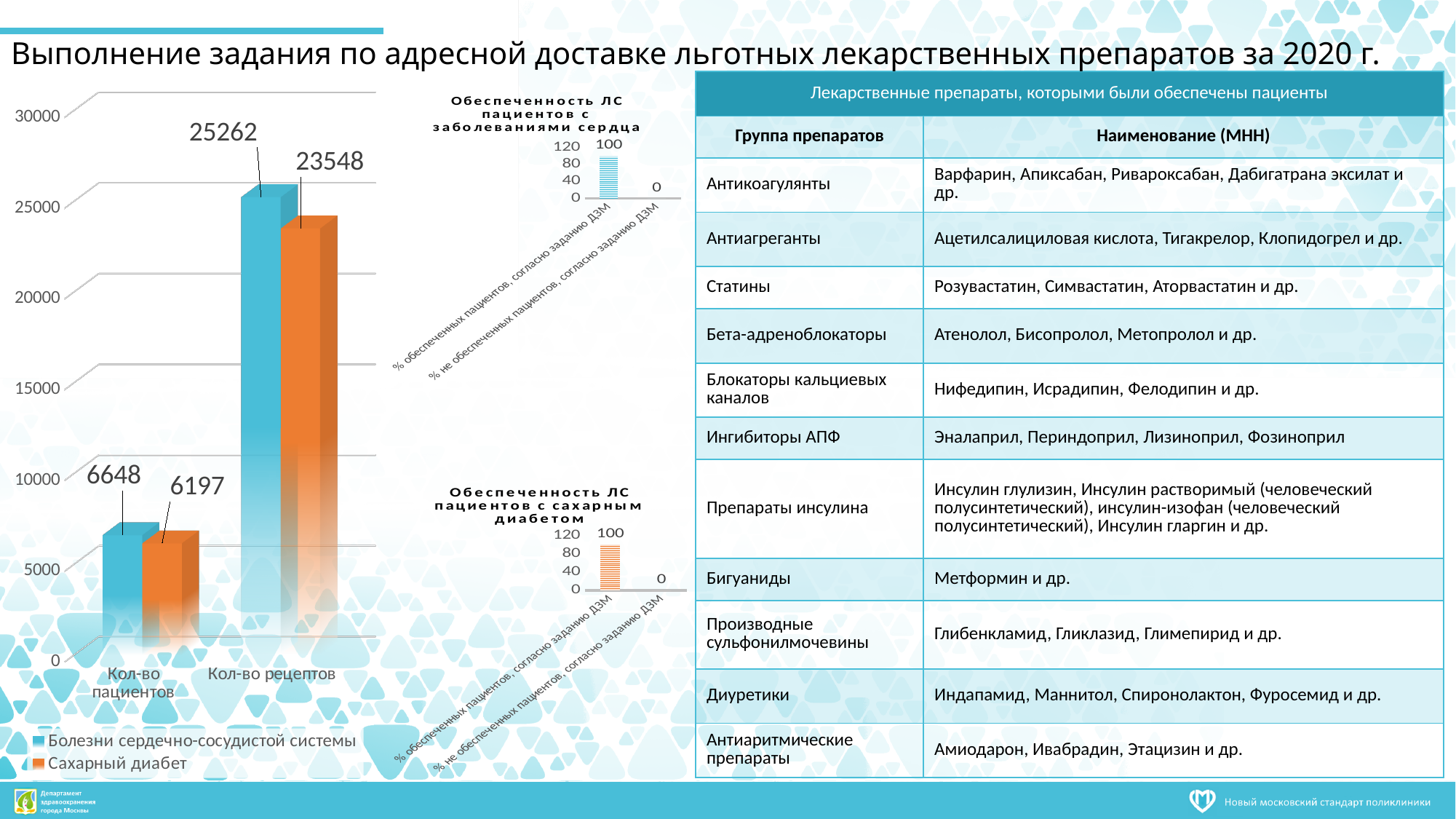
In the chart titled 'Обеспеченность ЛС пациентов с сахарным диабетом', what is the value for '% не обеспеченных пациентов, согласно заданию ДЗМ'? 0 In the large bar chart on the left, what is the value for 'Кол-во рецептов' in the 'Сахарный диабет' series? 23548 How many categories are shown on the x axis of the large bar chart on the left? 2 In the large bar chart on the left, what is the difference between the 'Кол-во пациентов' values for 'Болезни сердечно-сосудистой системы' and 'Сахарный диабет'? 451 In the large bar chart on the left, which series has the higher value for 'Кол-во рецептов'? Болезни сердечно-сосудистой системы What kind of chart is the large chart on the left of the slide? Bar chart In the large bar chart on the left, what is the value for 'Кол-во рецептов' in the 'Болезни сердечно-сосудистой системы' series? 25262 In the large bar chart on the left, what is the value for 'Кол-во пациентов' in the 'Сахарный диабет' series? 6197 In the large bar chart on the left, what is the value for 'Кол-во пациентов' in the 'Болезни сердечно-сосудистой системы' series? 6648 In the chart titled 'Обеспеченность ЛС пациентов с заболеваниями сердца', what is the value for '% обеспеченных пациентов, согласно заданию ДЗМ'? 100 How many series does the legend of the large bar chart on the left list? 2 In the large bar chart on the left, what is the difference between the 'Кол-во рецептов' values for 'Болезни сердечно-сосудистой системы' and 'Сахарный диабет'? 1714